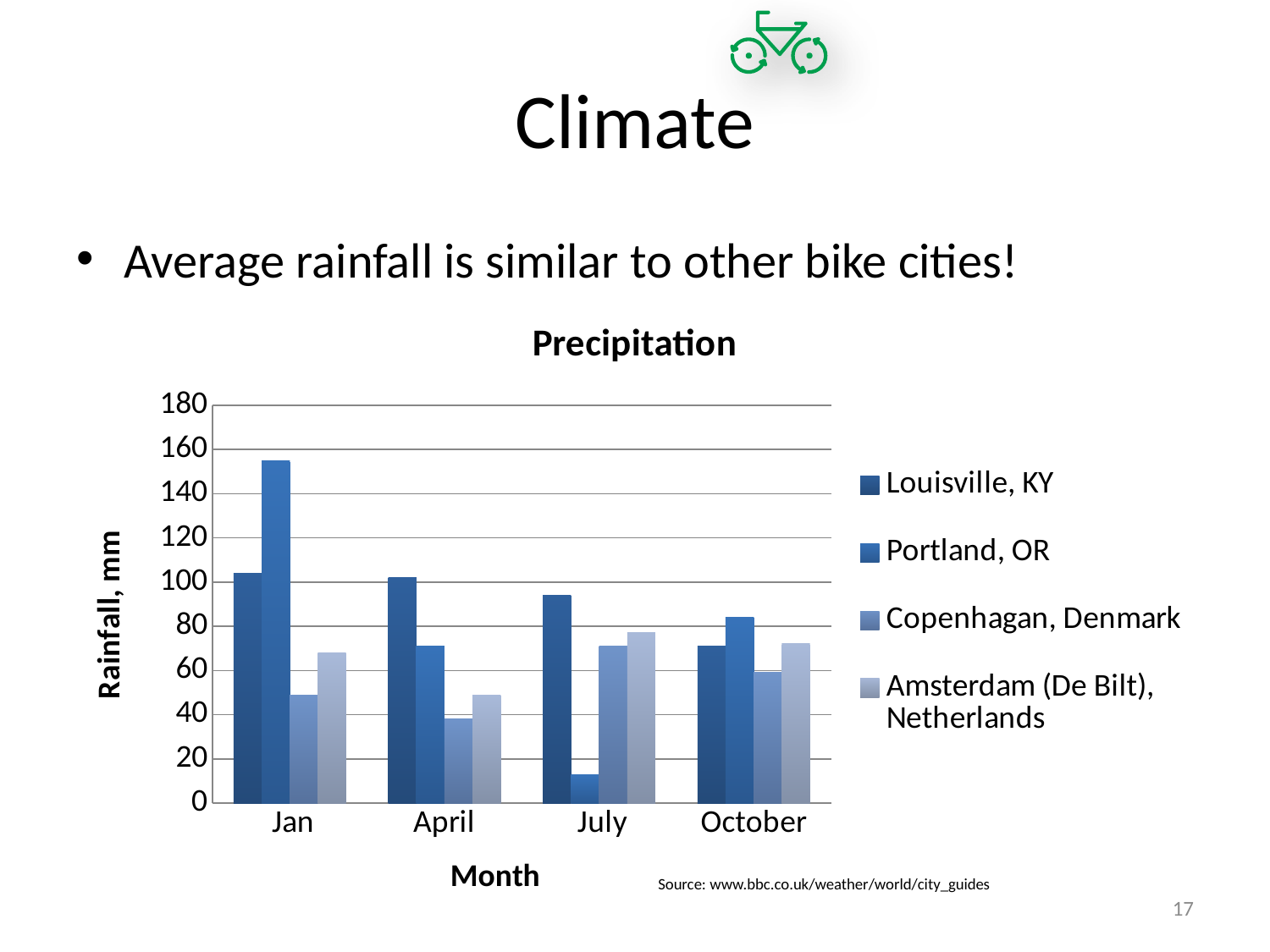
How many series does the legend list? 4 What kind of chart is shown on the slide? bar chart In which month is the Portland, OR bar the lowest? July How many months are shown on the x axis? 4 Is the value for Portland, OR in Jan greater or less than 140? greater In July, which is larger: Louisville, KY or Portland, OR? Louisville, KY In Jan, which is larger: Louisville, KY or Portland, OR? Portland, OR What is the label on the y axis? Rainfall, mm Do the Louisville, KY bars rise or fall from Jan to October? fall Is the value for Amsterdam (De Bilt), Netherlands in July greater or less than 60? greater Is the value for Portland, OR in July greater or less than 20? less In which month is the Portland, OR bar the highest? Jan